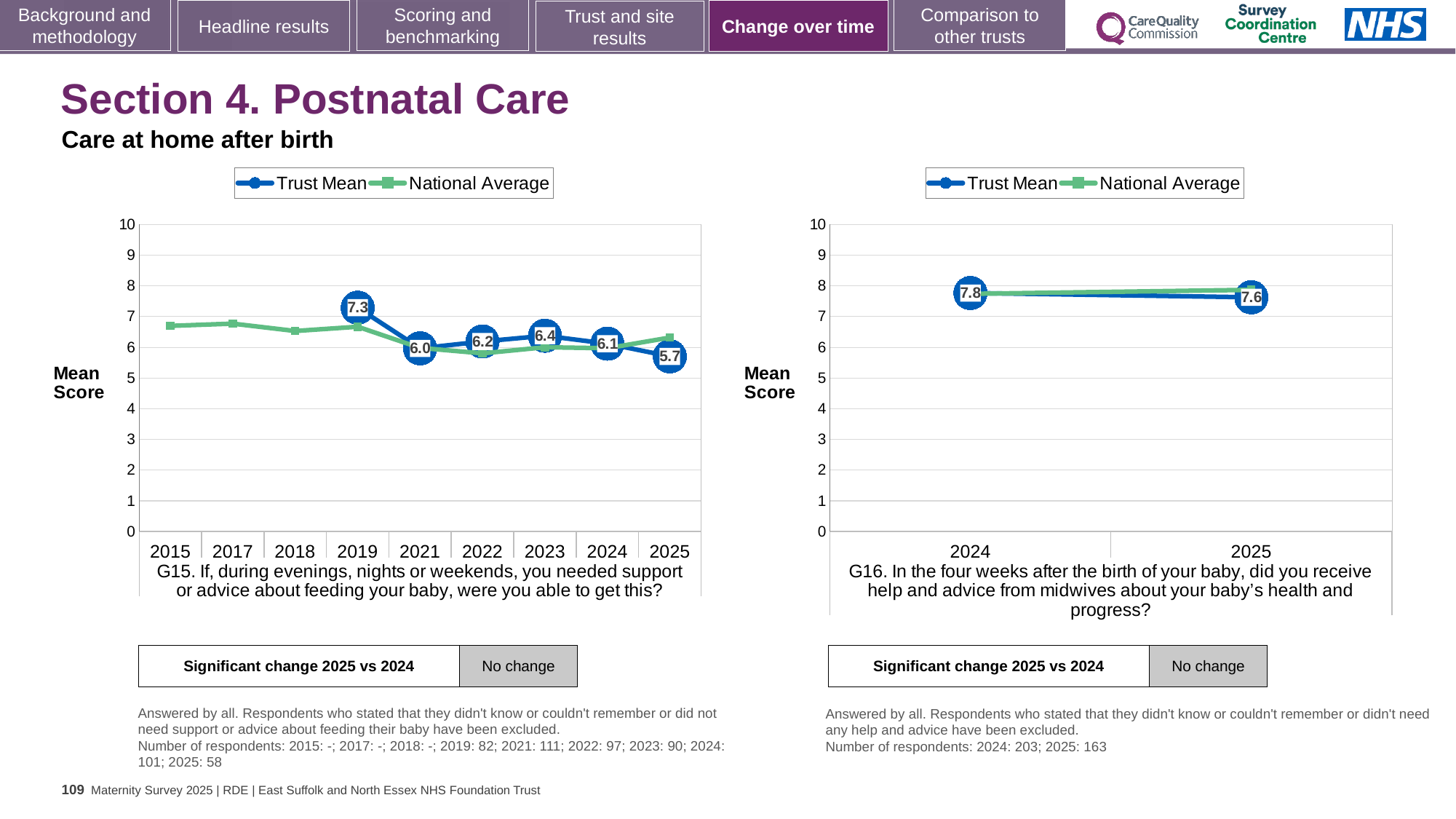
In the G15 chart on the left, what is the Trust Mean for 2019? 7.3 In the G15 chart on the left, what is the difference between the Trust Mean in 2019 and in 2025? 1.6 In the G16 chart on the right, what is the Trust Mean for 2024? 7.8 In the G15 chart on the left, what is the Trust Mean for 2025? 5.7 What type of chart is the G16 chart on the right? Line chart In the G16 chart on the right, what is the difference between the Trust Mean in 2024 and in 2025? 0.2 How many years are shown on the x axis of the G15 chart on the left? 9 In the G15 chart on the left, is the Trust Mean higher in 2023 or in 2024? 2023 In the G15 chart on the left, is the National Average for 2015 greater or less than 6? greater In the G15 chart on the left, which year has the lowest Trust Mean? 2025 In the G15 chart on the left, which year has the highest Trust Mean? 2019 How many series does the legend of the G16 chart on the right list? 2